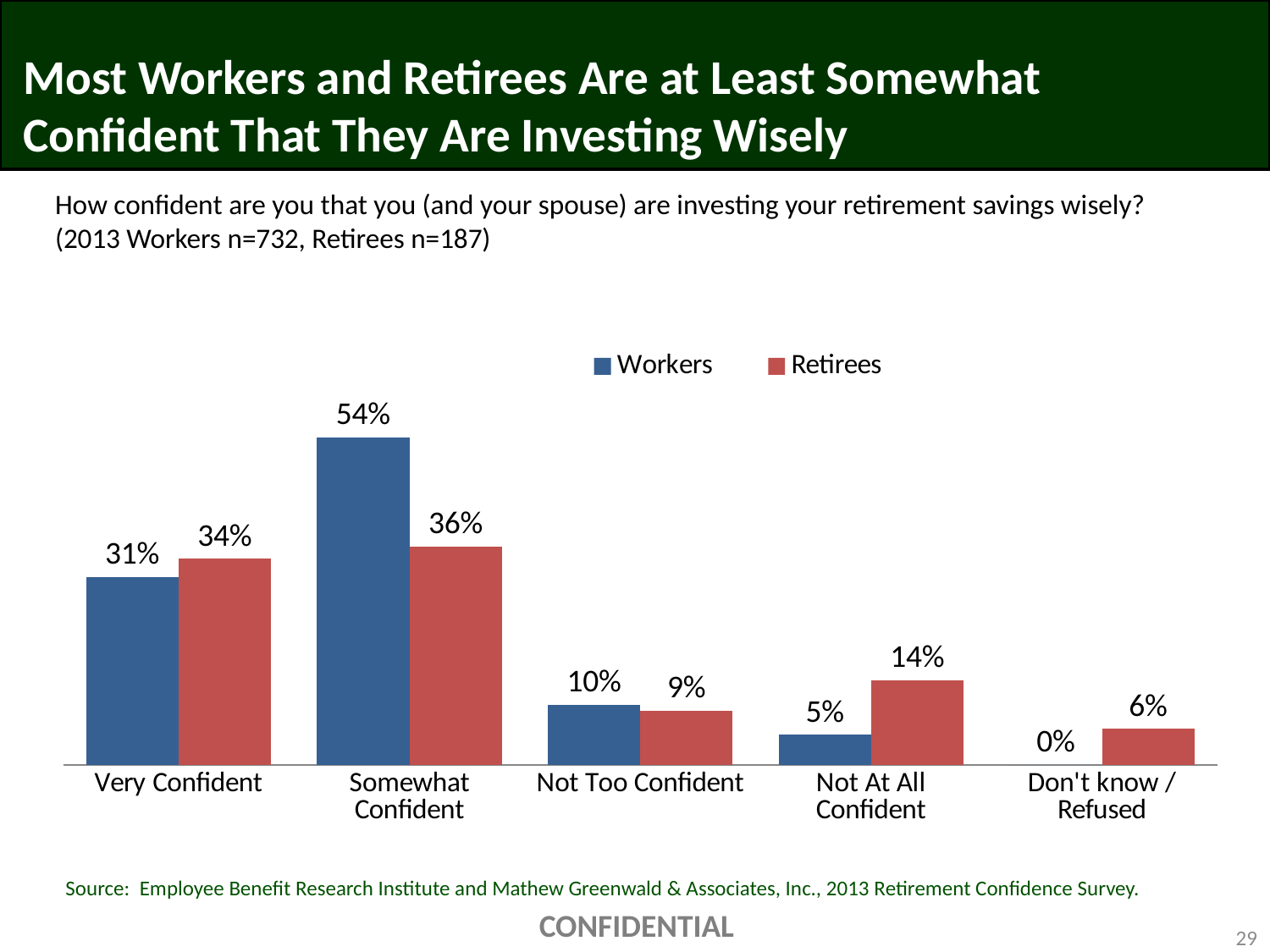
What percentage of Workers are Somewhat Confident? 54% How many response categories are shown on the x axis? 5 Which is larger for Not At All Confident, Workers or Retirees? Retirees What is the difference between Workers and Retirees for Somewhat Confident? 18% What percentage of Retirees are Very Confident? 34% Which colour represents Retirees in the chart? Red What percentage of Retirees are Not At All Confident? 14% What kind of chart is shown on the slide? Bar chart Which category has the highest value for Workers? Somewhat Confident How many series does the legend list? 2 Which category has the lowest value for Retirees? Don't know / Refused What percentage of Workers answered Don't know / Refused? 0%